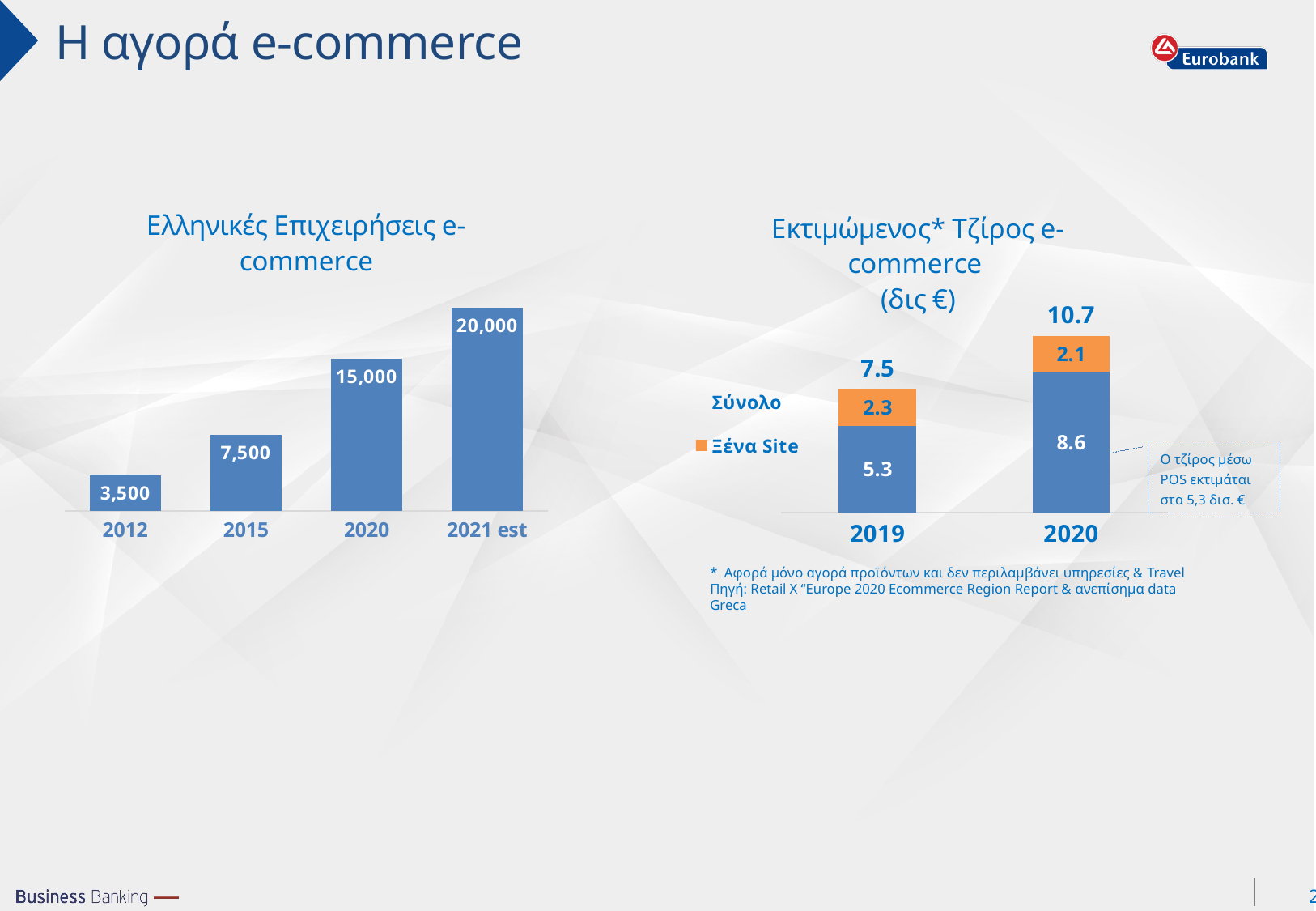
In the chart titled 'Ελληνικές Επιχειρήσεις e-commerce', how many categories are shown on the x axis? 4 In the chart titled 'Ελληνικές Επιχειρήσεις e-commerce', which category has the highest value? 2021 est In the chart titled 'Εκτιμώμενος* Τζίρος e-commerce (δις €)', what is the total of the stacked bar for 2020? 10.7 In the chart titled 'Ελληνικές Επιχειρήσεις e-commerce', what is the difference between the values for 2021 est and 2015? 12,500 In the chart titled 'Εκτιμώμενος* Τζίρος e-commerce (δις €)', what is the value of the 'Ξένα Site' segment for 2019? 2.3 What kind of chart is the chart titled 'Εκτιμώμενος* Τζίρος e-commerce (δις €)'? stacked bar chart In the chart titled 'Ελληνικές Επιχειρήσεις e-commerce', what is the value for 2012? 3,500 In the chart titled 'Ελληνικές Επιχειρήσεις e-commerce', which category has the lowest value? 2012 In the chart titled 'Εκτιμώμενος* Τζίρος e-commerce (δις €)', what is the difference between the blue segment values for 2020 and 2019? 3.3 In the chart titled 'Ελληνικές Επιχειρήσεις e-commerce', do the values rise or fall from 2012 to 2021 est? rise In the chart titled 'Ελληνικές Επιχειρήσεις e-commerce', what is the value for 2020? 15,000 In the chart titled 'Εκτιμώμενος* Τζίρος e-commerce (δις €)', which year has the larger total, 2019 or 2020? 2020